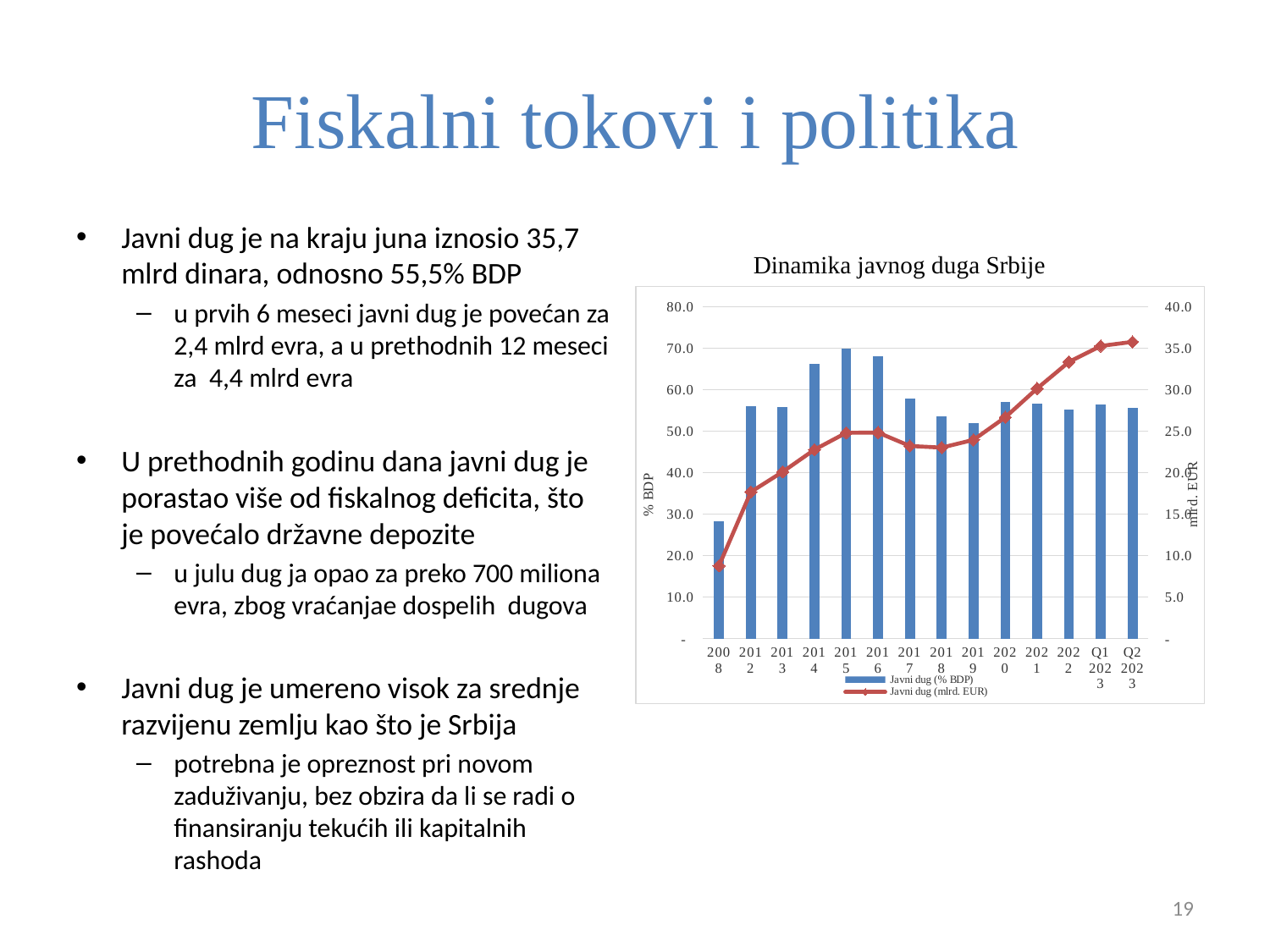
How many time periods are shown on the x axis of the 'Dinamika javnog duga Srbije' chart? 14 In which year is the bar for Javni dug (% BDP) the highest? 2015 Is the Javni dug (mlrd. EUR) value for 2008 greater or less than 10? less What kind of chart is 'Dinamika javnog duga Srbije'? A combined bar and line chart Is the Javni dug (% BDP) value for 2015 greater or less than 60? greater How many series does the legend of the 'Dinamika javnog duga Srbije' chart list? 2 In which year is the bar for Javni dug (% BDP) the lowest? 2008 Which is larger, the Javni dug (% BDP) bar for 2012 or for 2015? 2015 Which series in the 'Dinamika javnog duga Srbije' chart is drawn as a line? Javni dug (mlrd. EUR) What is the label of the left vertical axis in the 'Dinamika javnog duga Srbije' chart? % BDP Does the Javni dug (mlrd. EUR) line generally rise or fall from 2008 to Q2 2023? rise At which period does the Javni dug (mlrd. EUR) line reach its highest value? Q2 2023